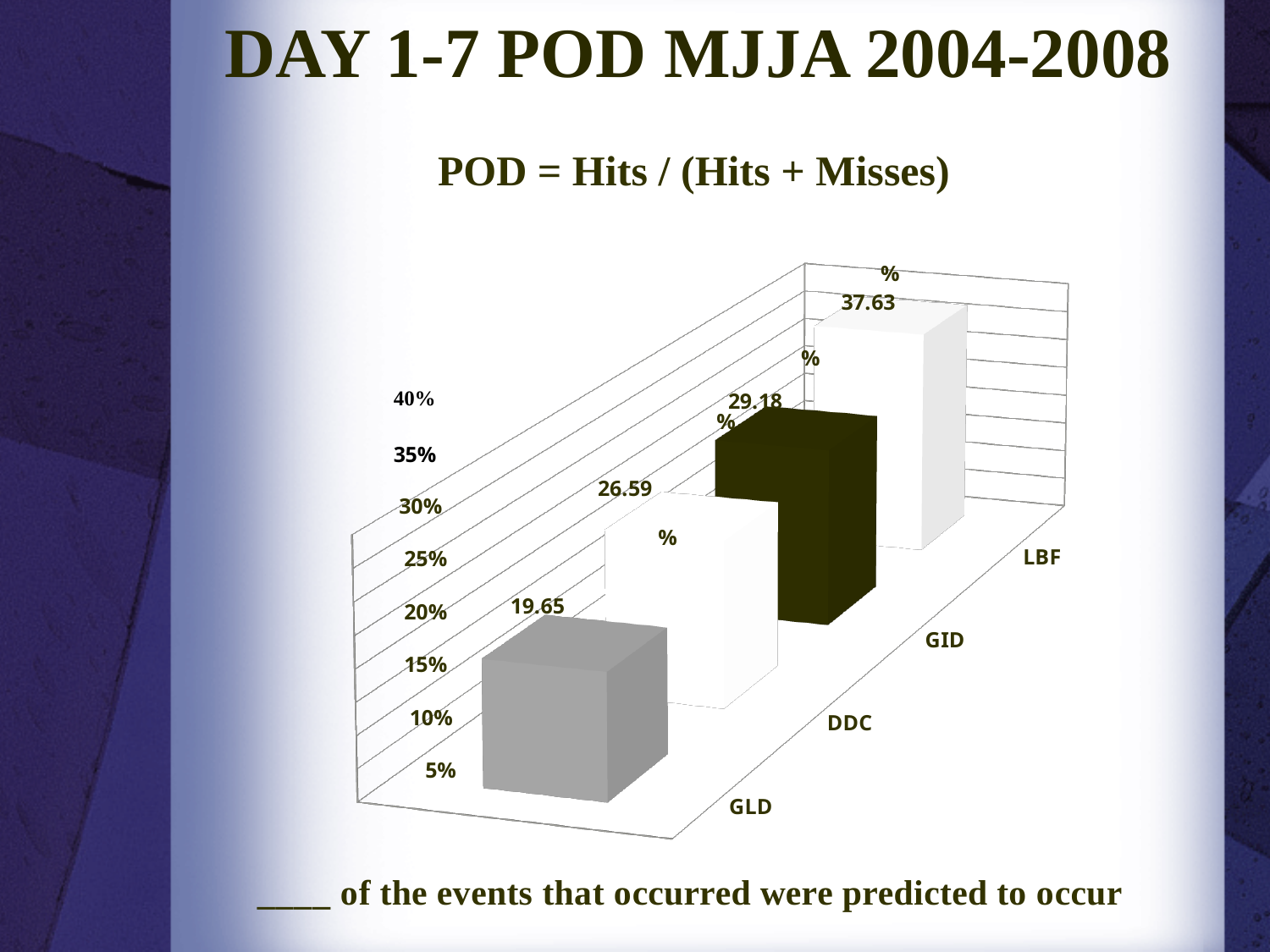
How many sites are shown in the chart? 4 Which site has the highest POD? LBF What is the difference between the POD for LBF and the POD for GLD? 17.98% Do the POD values rise or fall going from GLD to LBF? rise What is the POD value for DDC? 26.59% Which site has the lowest POD? GLD What is the POD value for LBF? 37.63% Is the POD value for GLD greater or less than 20%? less Which has a higher POD, DDC or GID? GID What is the POD value for GLD? 19.65% What is the POD value for GID? 29.18% What kind of chart is shown on the slide? bar chart